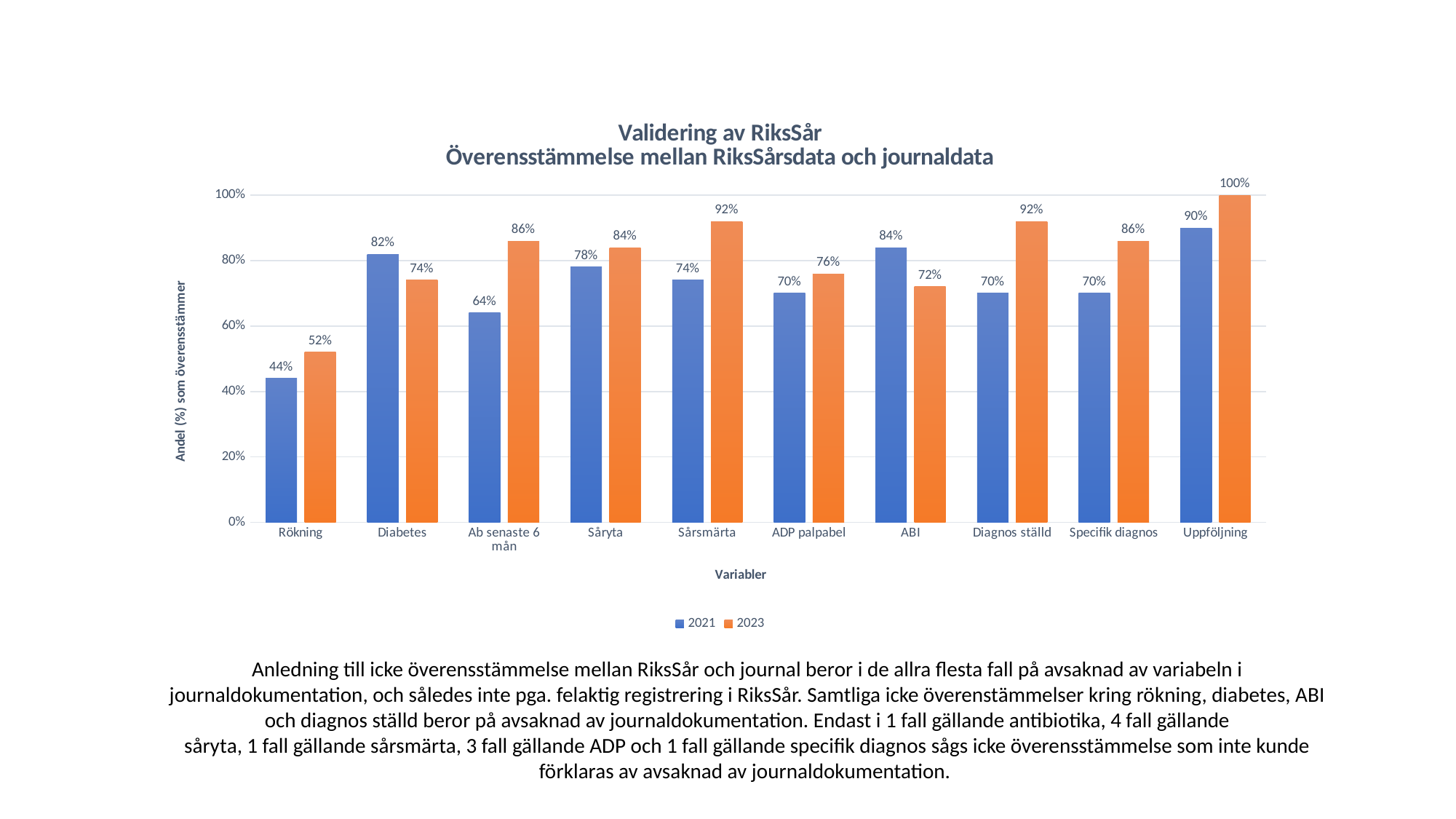
What is the 2021 value for Ab senaste 6 mån? 64% What is the label of the y axis? Andel (%) som överensstämmer How many series does the legend list? 2 Which category has the lowest 2021 value? Rökning Which category has the highest 2023 value? Uppföljning Which series is shown in orange? 2023 What kind of chart is shown on the slide? Bar chart What is the 2023 value for Sårsmärta? 92% What is the difference between the 2023 and 2021 values for Ab senaste 6 mån? 22% How many categories are shown on the x axis? 10 Which is larger for Diabetes, the 2021 value or the 2023 value? 2021 What is the 2021 value for Rökning? 44%